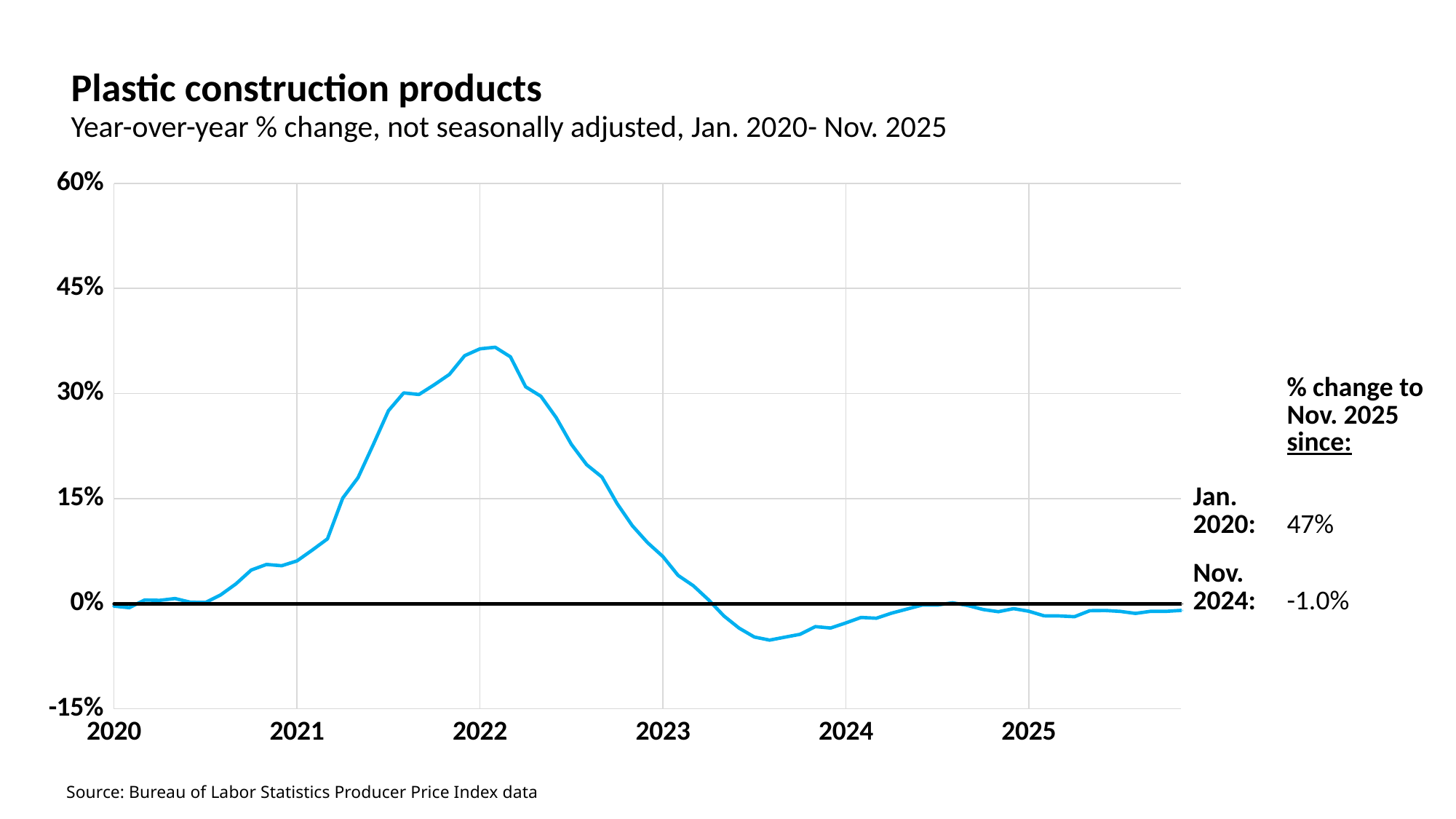
In which year does the line reach its highest value? 2022 What is the title of the chart? Plastic construction products Does the line rise or fall between the start of 2022 and the start of 2023? fall According to the annotation, what is the % change to Nov. 2025 since Nov. 2024? -1.0% Is the value of the line at the start of 2023 greater or less than 0%? greater Which is larger, the value of the line at the start of 2022 or at the start of 2024? start of 2022 What kind of chart is shown on the slide? line chart Is the value of the line at the start of 2024 greater or less than 15%? less Is the lowest value of the line in late 2023 greater or less than 0%? less In which year does the line reach its lowest value? 2023 According to the annotation, what is the % change to Nov. 2025 since Jan. 2020? 47%